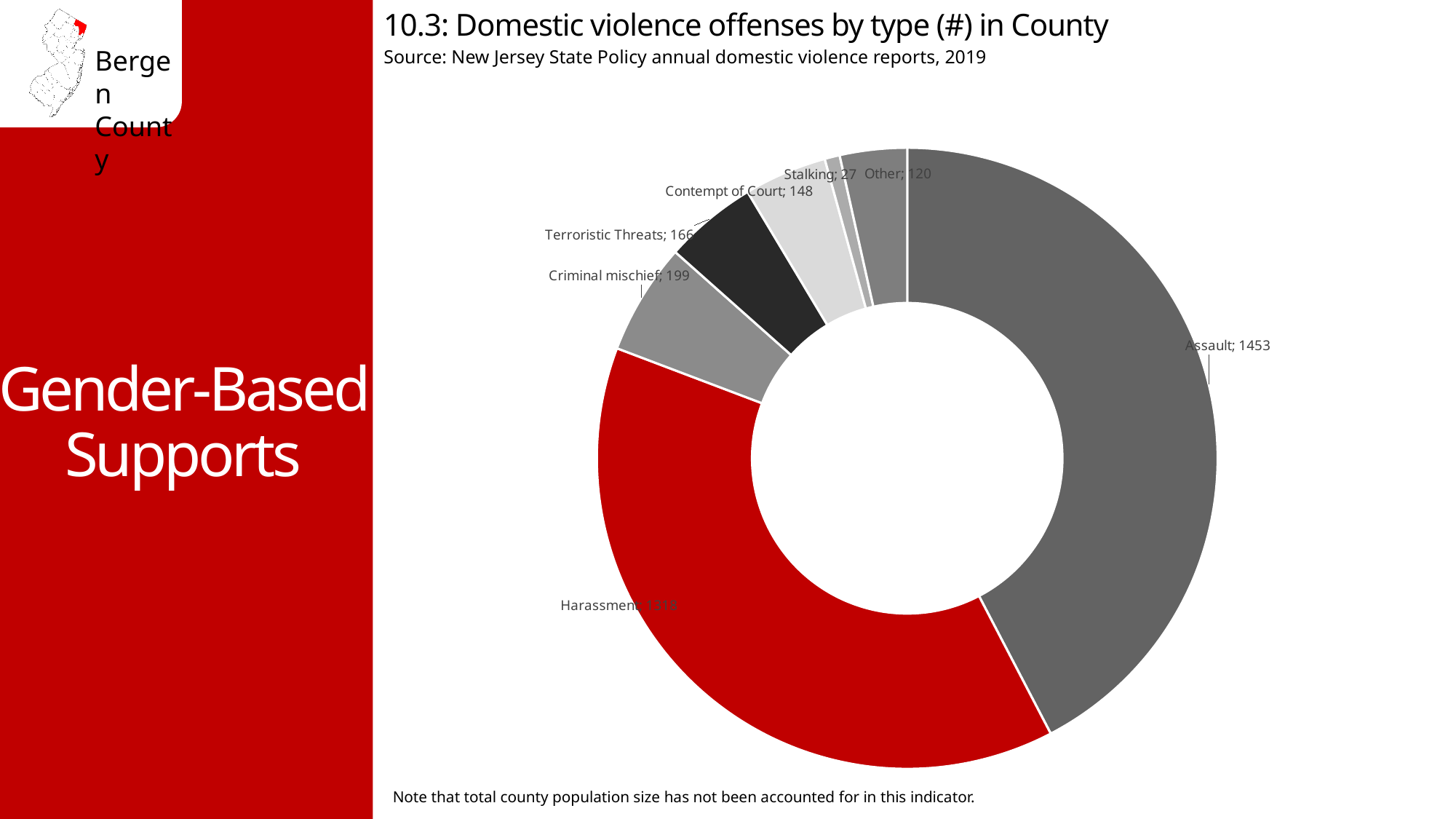
What is the difference between Criminal mischief and Terroristic Threats? 33 Which offense type has the highest number of offenses? Assault What is the number of Harassment offenses shown in the chart? 1318 What type of chart is shown on the slide? Doughnut (pie) chart Which offense type has the lowest number of offenses? Stalking What is the value for Criminal mischief? 199 How many offense types are shown in the chart? 7 What is the difference between the Harassment and Assault values? 135 Which is larger, Contempt of Court or Other? Contempt of Court What is the source cited for the chart? New Jersey State Policy annual domestic violence reports, 2019 What is the value for Stalking? 27 What is the number of Assault offenses shown in the chart? 1453